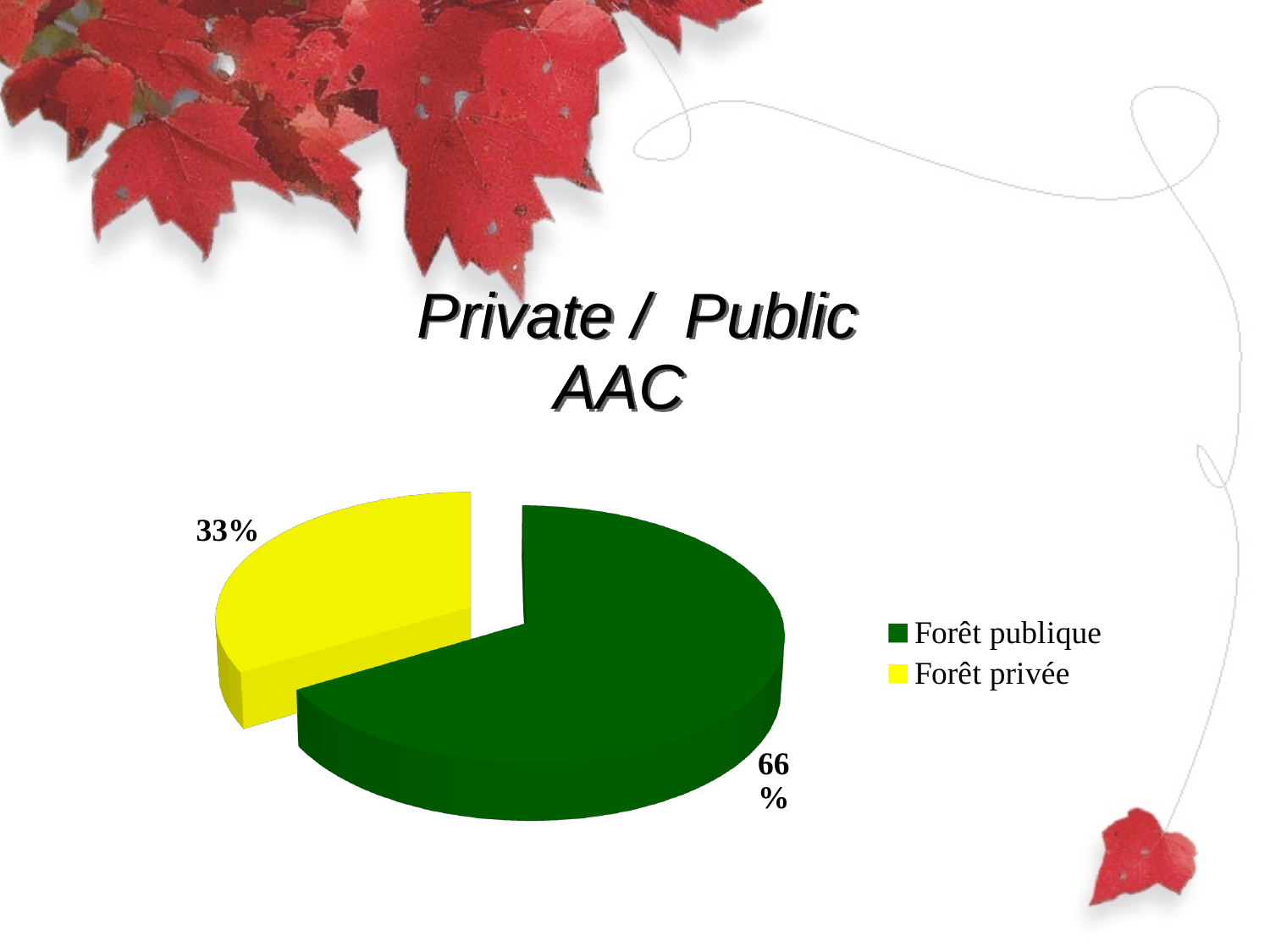
Which category has the largest slice of the pie? Forêt publique What share of the pie does Forêt privée represent? 33% Which category has the smallest slice of the pie? Forêt privée What kind of chart is shown on the slide? pie chart What is the difference in percentage points between the Forêt publique and Forêt privée slices? 33 How many entries does the legend list? 2 What colour is the Forêt privée slice? yellow What share of the pie does Forêt publique represent? 66% What is the title shown above the chart? Private / Public AAC Which is larger, the slice for Forêt publique or the slice for Forêt privée? Forêt publique How many slices does the pie chart have? 2